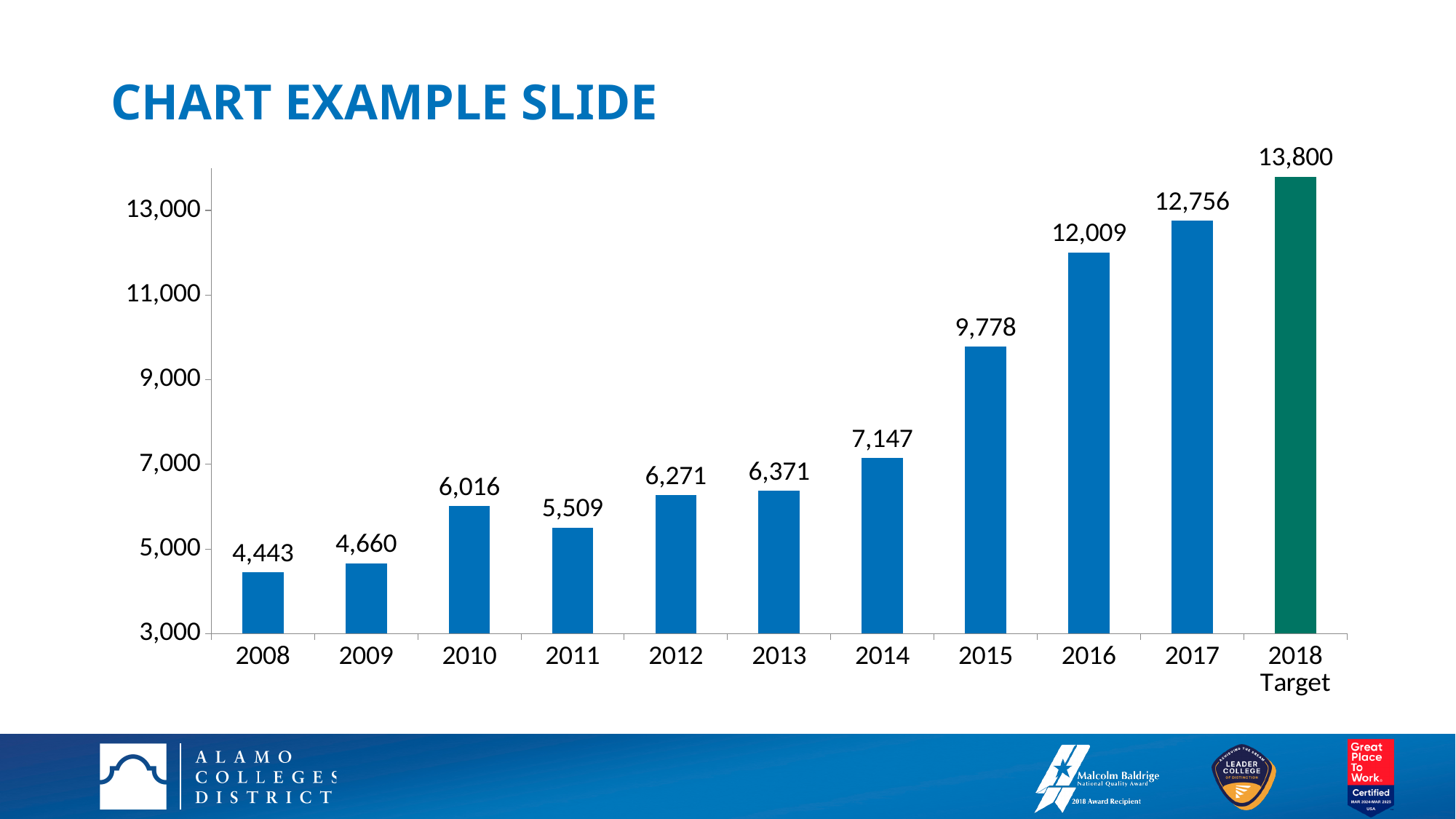
Which bar is shown in a different colour (green) from the others? 2018 Target What is the value for the 2018 Target? 13,800 What is the value for 2010? 6,016 What is the difference between the 2018 Target and the 2017 value? 1,044 Which is larger, the value for 2011 or the value for 2012? 2012 What kind of chart is shown on the slide? bar chart How many bars are shown in the chart? 11 Which category has the highest value? 2018 Target Is the value for 2015 greater or less than 9,000? greater Which year has the lowest value? 2008 What is the difference between the values for 2011 and 2010? 507 What is the value for 2016? 12,009